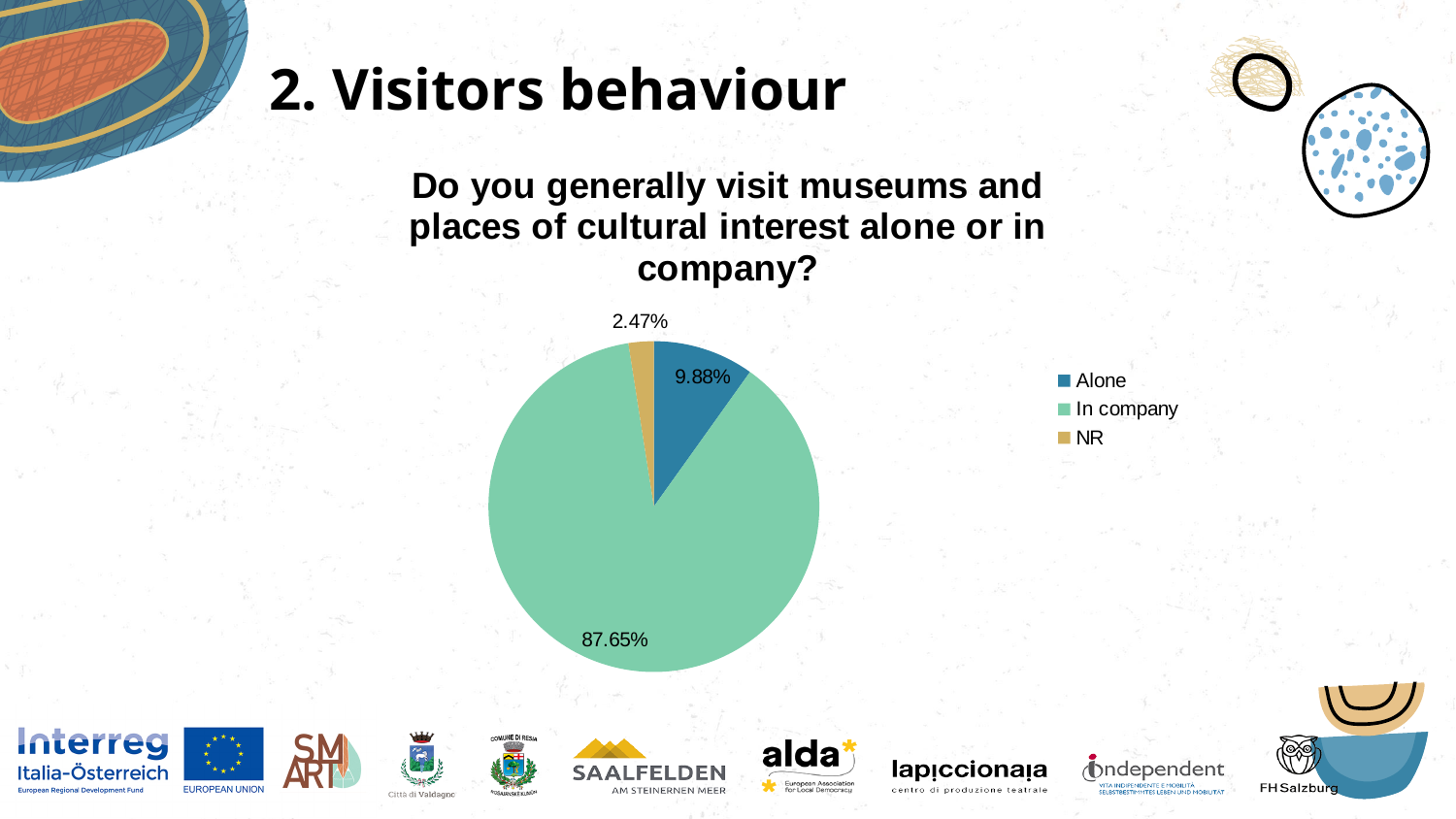
What kind of chart is shown on the slide? Pie chart Which is larger, the share for 'Alone' or the share for 'NR'? Alone What percentage of respondents visit museums in company? 87.65% Which colour represents 'In company' in the legend? Green How many entries does the legend list? 3 What is the difference in percentage points between 'In company' and 'Alone'? 77.77 Which category has the smallest share of the pie? NR Which category has the largest share of the pie? In company How many categories does the pie chart show? 3 What percentage of respondents visit museums alone? 9.88% What question does the chart answer, according to the text above it? Do you generally visit museums and places of cultural interest alone or in company? What percentage of respondents gave no response (NR)? 2.47%